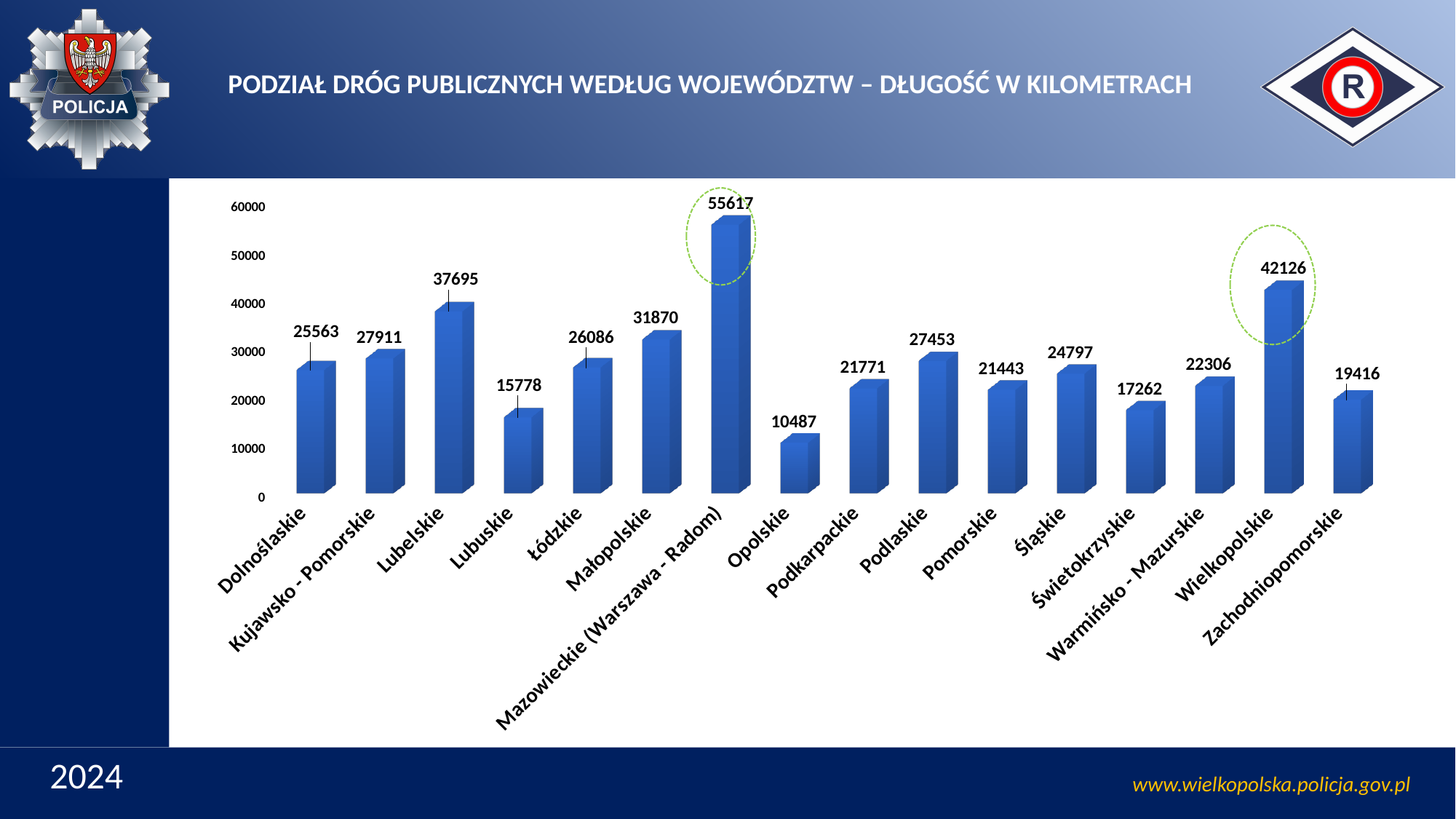
What is the value for Opolskie? 10487 What is the difference between the values for Mazowieckie (Warszawa - Radom) and Wielkopolskie? 13491 What is the title of the slide? PODZIAŁ DRÓG PUBLICZNYCH WEDŁUG WOJEWÓDZTW – DŁUGOŚĆ W KILOMETRACH Which voivodeship has the highest value? Mazowieckie (Warszawa - Radom) What is the value for Wielkopolskie? 42126 How many voivodeships are shown on the x axis? 16 What is the value for Lubelskie? 37695 What kind of chart is shown on the slide? bar chart What is the difference between the values for Wielkopolskie and Lubelskie? 4431 Which is larger, the value for Lubelskie or the value for Małopolskie? Lubelskie Is the value for Lubuskie greater or less than 20000? less Which voivodeship has the lowest value? Opolskie